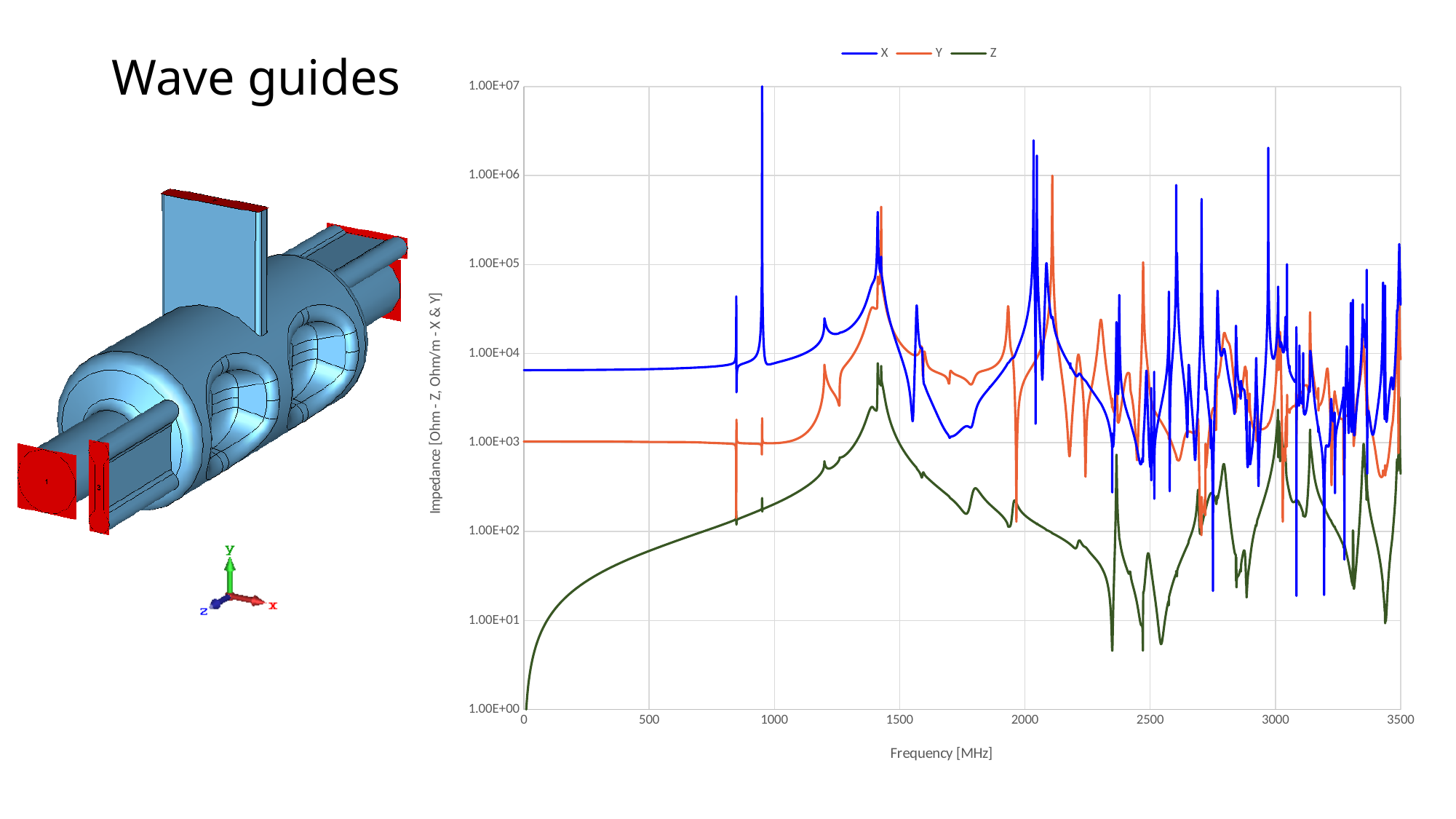
What is the title of the chart's horizontal axis? Frequency [MHz] What are the legend entries of the chart? X, Y, Z Does the Z series rise or fall between 0 and 1000 MHz? rise Which series has the lowest value at 500 MHz? Z How many series does the chart's legend list? 3 Which series reaches the highest peak value on the chart? X At 500 MHz, which series has the larger value, X or Y? X Is the value of the X series at 500 MHz greater or less than 1.00E+03? greater What kind of chart is shown on the slide? line chart Is the value of the Z series at 500 MHz greater or less than 1.00E+02? less Is the value of the Y series at 200 MHz greater or less than 1.00E+04? less